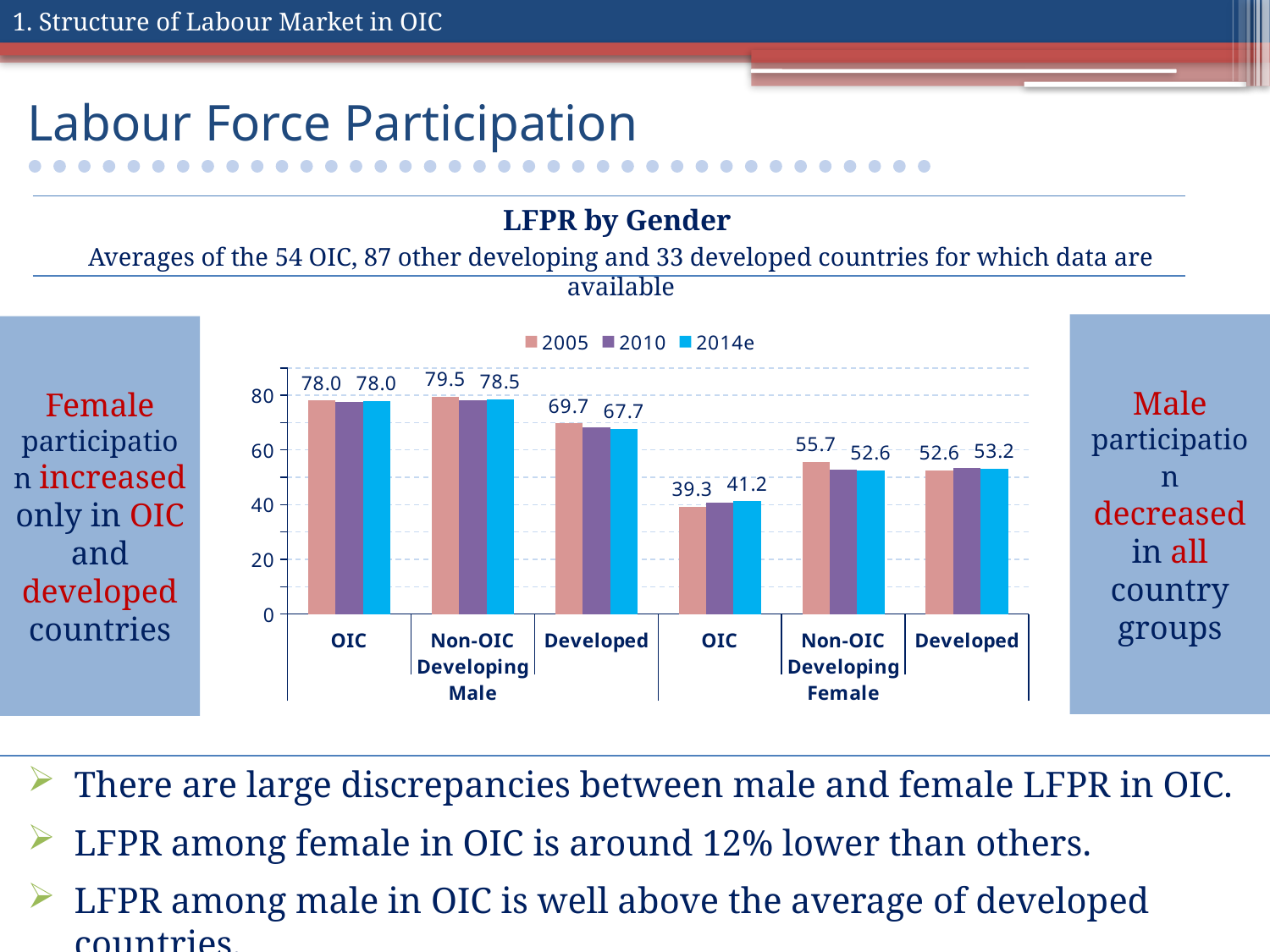
What kind of chart is shown? bar chart Is the 2014e value for Female Non-OIC Developing countries larger or smaller than the 2014e value for Female Developed countries? smaller What is the 2005 value for Female Non-OIC Developing countries? 55.7 How many series does the legend list? 3 What is the difference between the 2005 and 2014e values for Male Developed countries? 2.0 What is the 2014e value for Male Developed countries? 67.7 Which category has the lowest 2005 value? Female OIC Did the value for Female OIC countries rise or fall from 2005 to 2014e? rise What is the 2005 value for Male Non-OIC Developing countries? 79.5 Is the 2010 value for Female OIC countries greater or less than 60? less What is the 2014e value for Female OIC countries? 41.2 Which category has the highest 2005 value? Male Non-OIC Developing